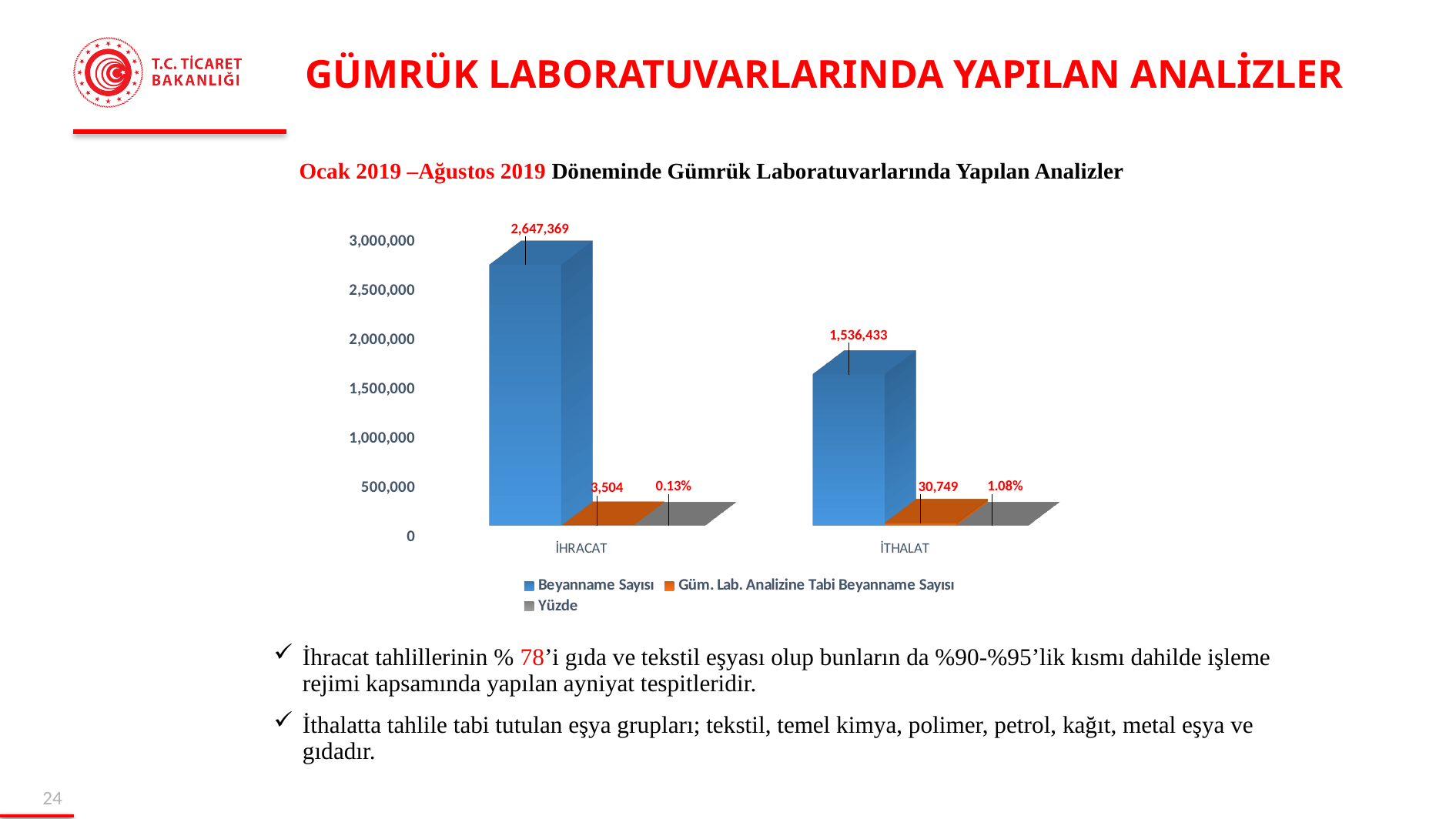
What is the Beyanname Sayısı value for İHRACAT? 2,647,369 Which category has the higher Beyanname Sayısı, İHRACAT or İTHALAT? İHRACAT What is the Beyanname Sayısı value for İTHALAT? 1,536,433 What is the Güm. Lab. Analizine Tabi Beyanname Sayısı value for İTHALAT? 30,749 What is the Yüzde value for İTHALAT? 1.08% What is the difference in Beyanname Sayısı between İHRACAT and İTHALAT? 1,110,936 Which category has the lower Güm. Lab. Analizine Tabi Beyanname Sayısı? İHRACAT What is the Güm. Lab. Analizine Tabi Beyanname Sayısı value for İHRACAT? 3,504 What is the difference in Güm. Lab. Analizine Tabi Beyanname Sayısı between İTHALAT and İHRACAT? 27,245 How many series does the legend list? 3 What kind of chart is shown on the slide? Bar chart How many categories are shown on the x axis? 2